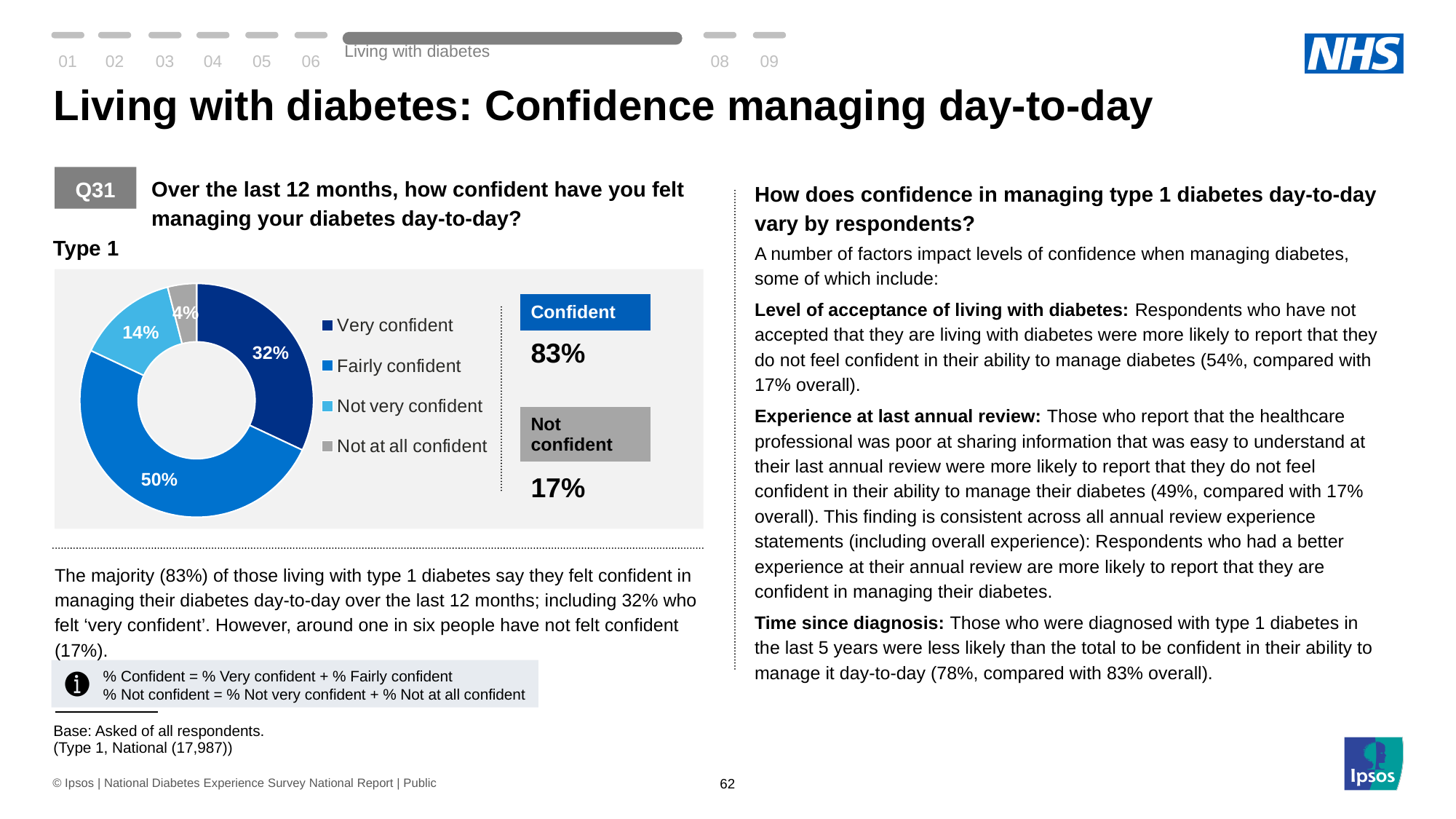
What is the difference in percentage points between 'Fairly confident' and 'Very confident'? 18 What percentage of respondents said they were 'Fairly confident'? 50% Which response category has the largest share of the chart? Fairly confident Which response category has the smallest share of the chart? Not at all confident What is the combined percentage shown for 'Not confident' next to the chart? 17% Which is larger: the share for 'Not very confident' or the share for 'Not at all confident'? Not very confident What percentage of respondents said they were 'Not very confident'? 14% What kind of chart is used to show the Type 1 responses? Doughnut (pie) chart What percentage of respondents said they were 'Not at all confident'? 4% How many response categories does the chart show? 4 What is the combined percentage shown for 'Confident' next to the chart? 83% What percentage of respondents said they were 'Very confident'? 32%